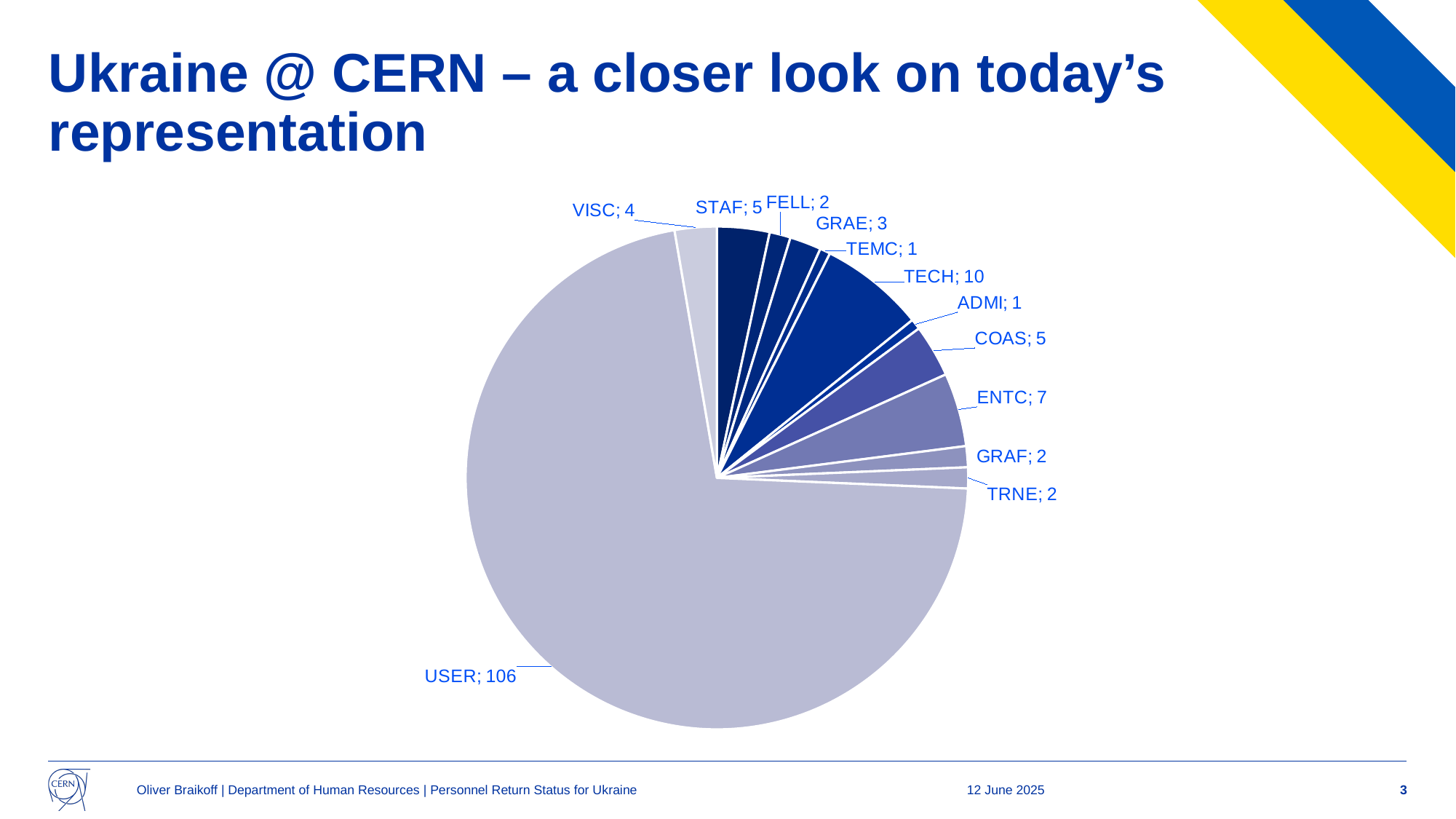
What is the value for ENTC in the pie chart? 7 What is the difference between the values for TECH and COAS? 5 What is the title of the slide containing the pie chart? Ukraine @ CERN – a closer look on today's representation What is the value for VISC in the pie chart? 4 What is the value for TECH in the pie chart? 10 What type of chart is shown on the slide? pie chart How many slices does the pie chart have? 12 What is the total of all the values shown in the pie chart? 148 Which category has the largest slice in the pie chart? USER What is the difference between the values for USER and TECH? 96 What is the value for USER in the pie chart? 106 Which is larger, the value for ENTC or the value for STAF? ENTC